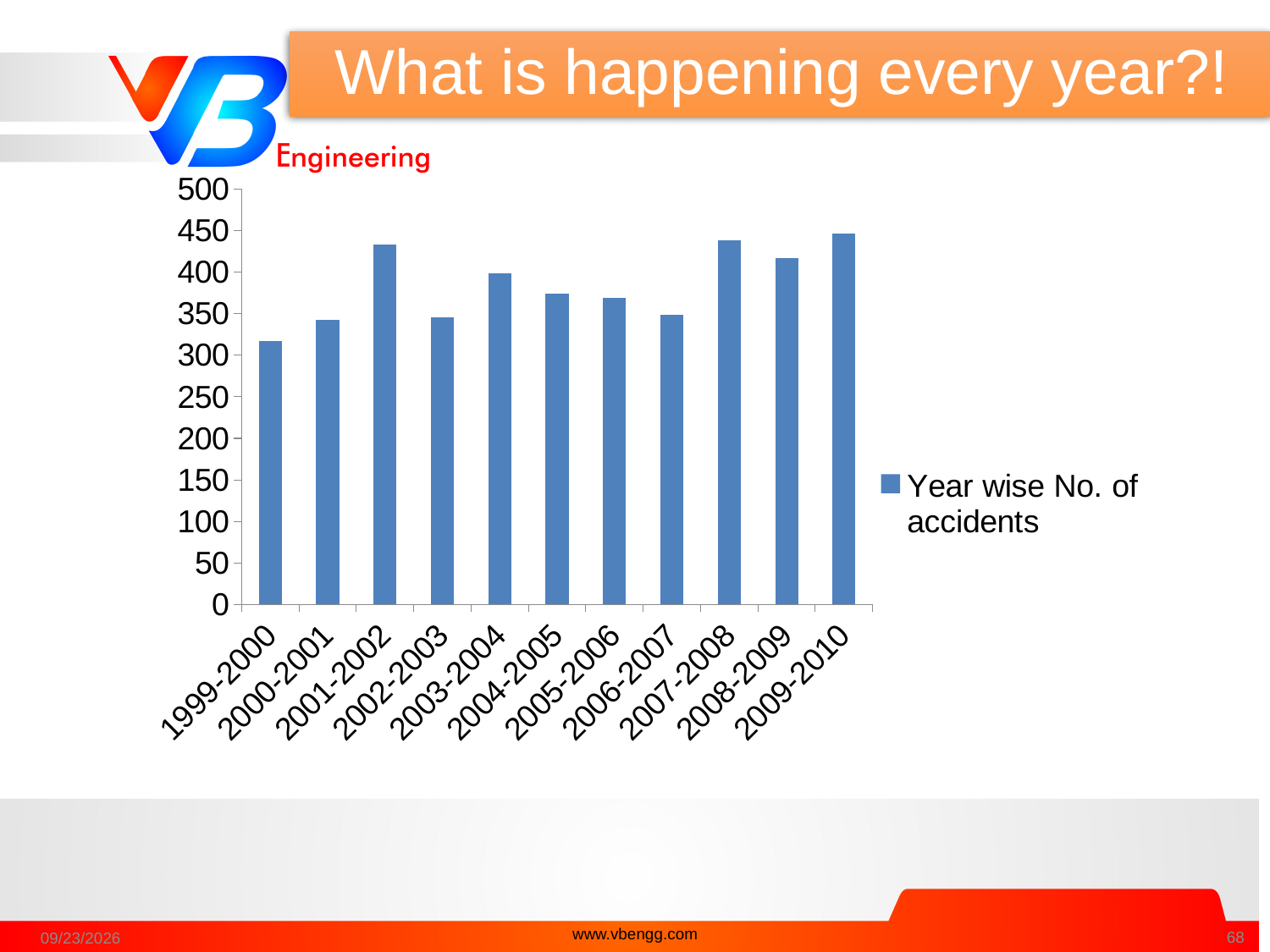
Which is larger, the value for 2008-2009 or the value for 2009-2010? 2009-2010 Is the value for 2008-2009 greater or less than 400? greater How many series does the legend list? 1 Is the value for 2006-2007 greater or less than 400? less What kind of chart is shown on the slide? bar chart Is the value for 1999-2000 greater or less than 300? greater Which year has the lowest number of accidents? 1999-2000 How many year categories are shown on the x axis? 11 Which is larger, the value for 2001-2002 or the value for 2002-2003? 2001-2002 What is the legend entry for the plotted series? Year wise No. of accidents Which is larger, the value for 2003-2004 or the value for 2004-2005? 2003-2004